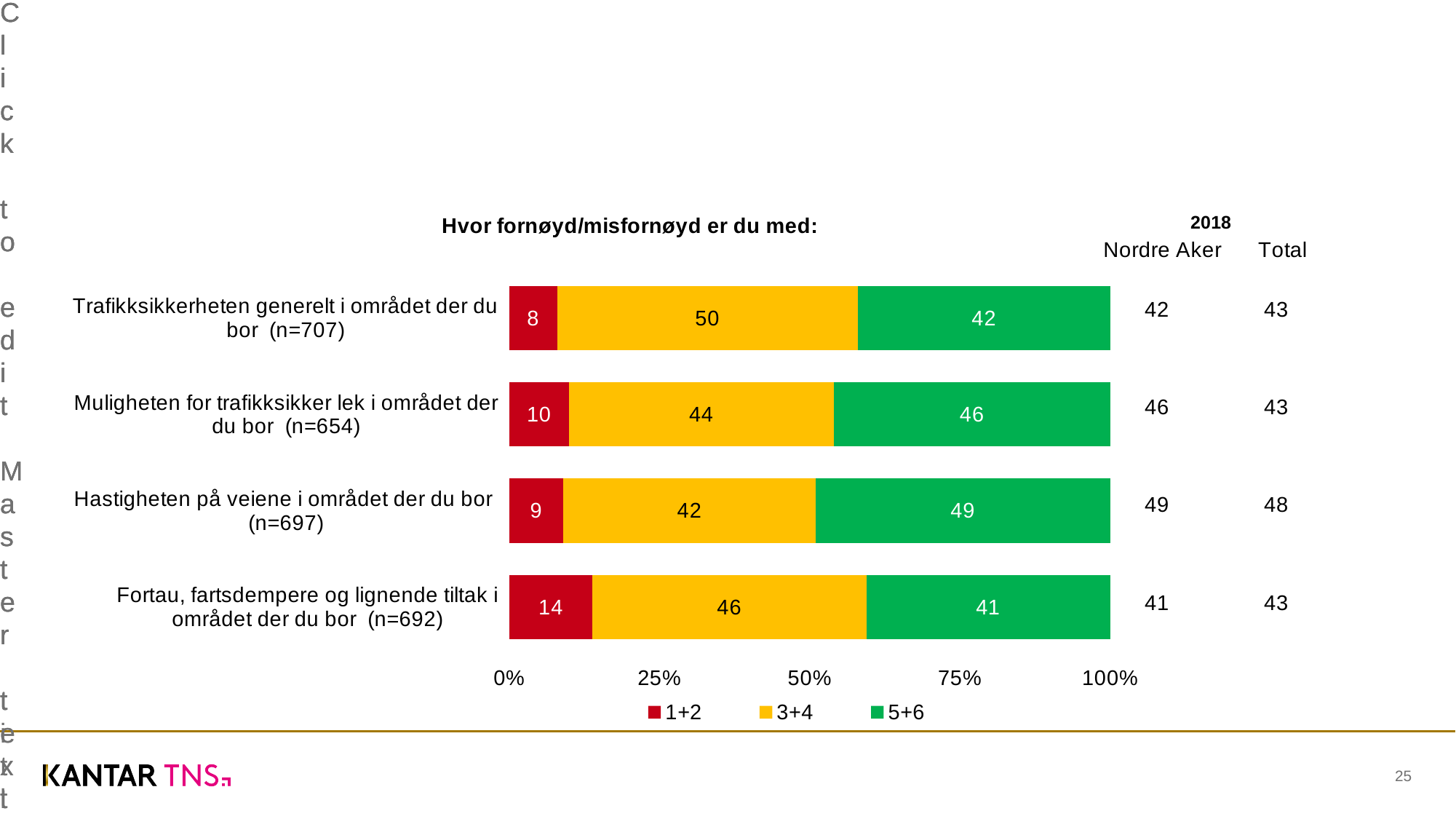
What colour represents the 5+6 series in the chart? green Which category has the highest value for the 1+2 series? Fortau, fartsdempere og lignende tiltak i området der du bor (n=692) What kind of chart is shown on the slide? stacked bar chart Which is larger: the 3+4 value for "Muligheten for trafikksikker lek i området der du bor (n=654)" or the 3+4 value for "Fortau, fartsdempere og lignende tiltak i området der du bor (n=692)"? Fortau, fartsdempere og lignende tiltak i området der du bor (n=692) How many series does the legend list? 3 What is the total of the stacked bar for "Muligheten for trafikksikker lek i området der du bor (n=654)"? 100 What is the value of the 3+4 series for "Trafikksikkerheten generelt i området der du bor (n=707)"? 50 What is the difference between the 5+6 values for "Hastigheten på veiene i området der du bor (n=697)" and "Trafikksikkerheten generelt i området der du bor (n=707)"? 7 How many categories are plotted in the chart? 4 Which category has the lowest value for the 5+6 series? Fortau, fartsdempere og lignende tiltak i området der du bor (n=692) What is the value of the 1+2 series for "Fortau, fartsdempere og lignende tiltak i området der du bor (n=692)"? 14 What is the value of the 5+6 series for "Hastigheten på veiene i området der du bor (n=697)"? 49